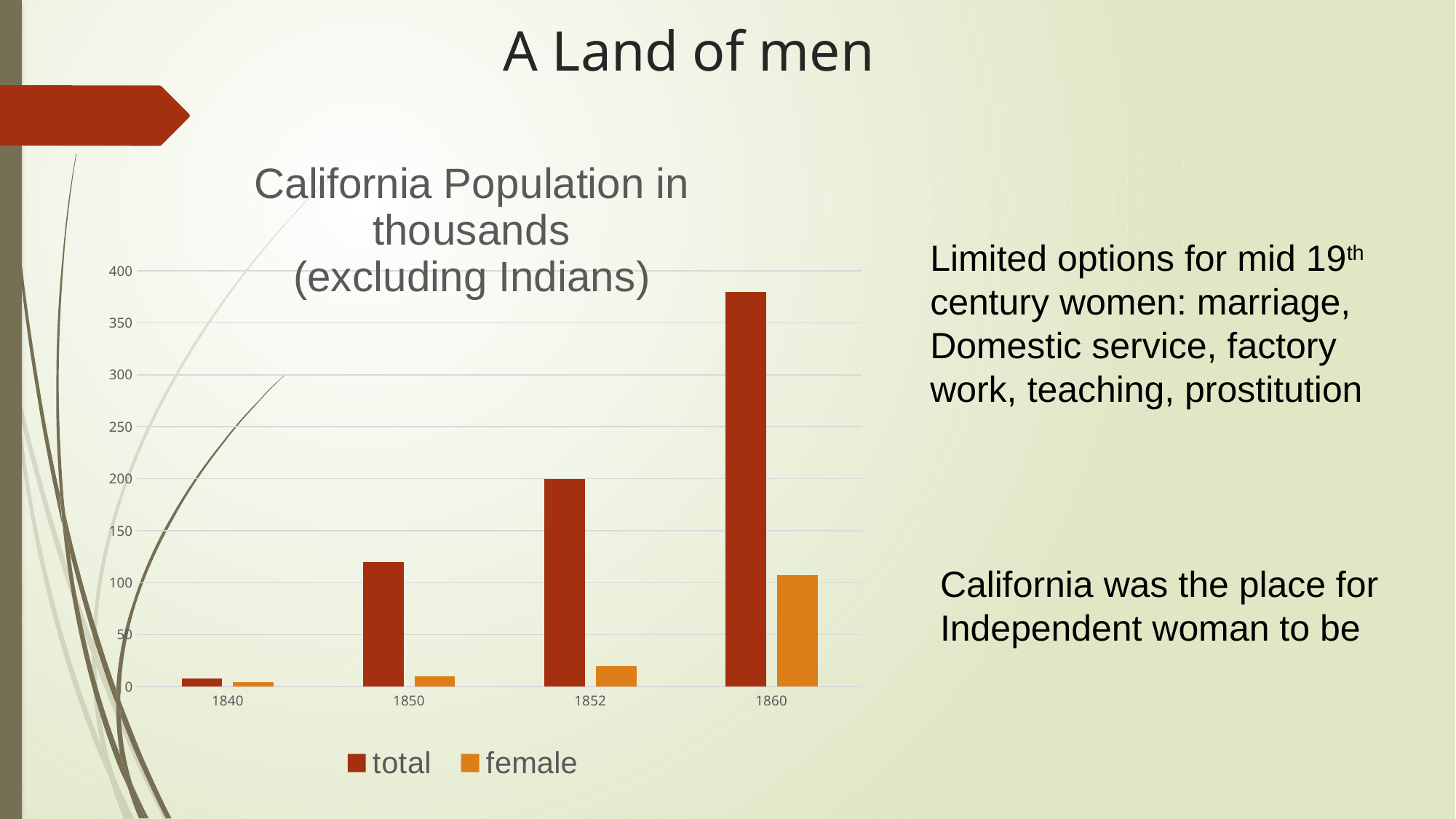
What is the title of the chart? California Population in thousands (excluding Indians) Which year has the lowest female population bar? 1840 Does the total population rise or fall from 1840 to 1860? rise Is the total population value for 1860 greater or less than 350? greater How many years are shown on the x axis of the chart? 4 Which year has the highest total population bar? 1860 Which is larger, the total population in 1850 or in 1852? 1852 Is the female population value for 1852 greater or less than 50? less Is the total population value for 1840 greater or less than 50? less How many series does the chart's legend list? 2 What kind of chart is shown on the slide? bar chart